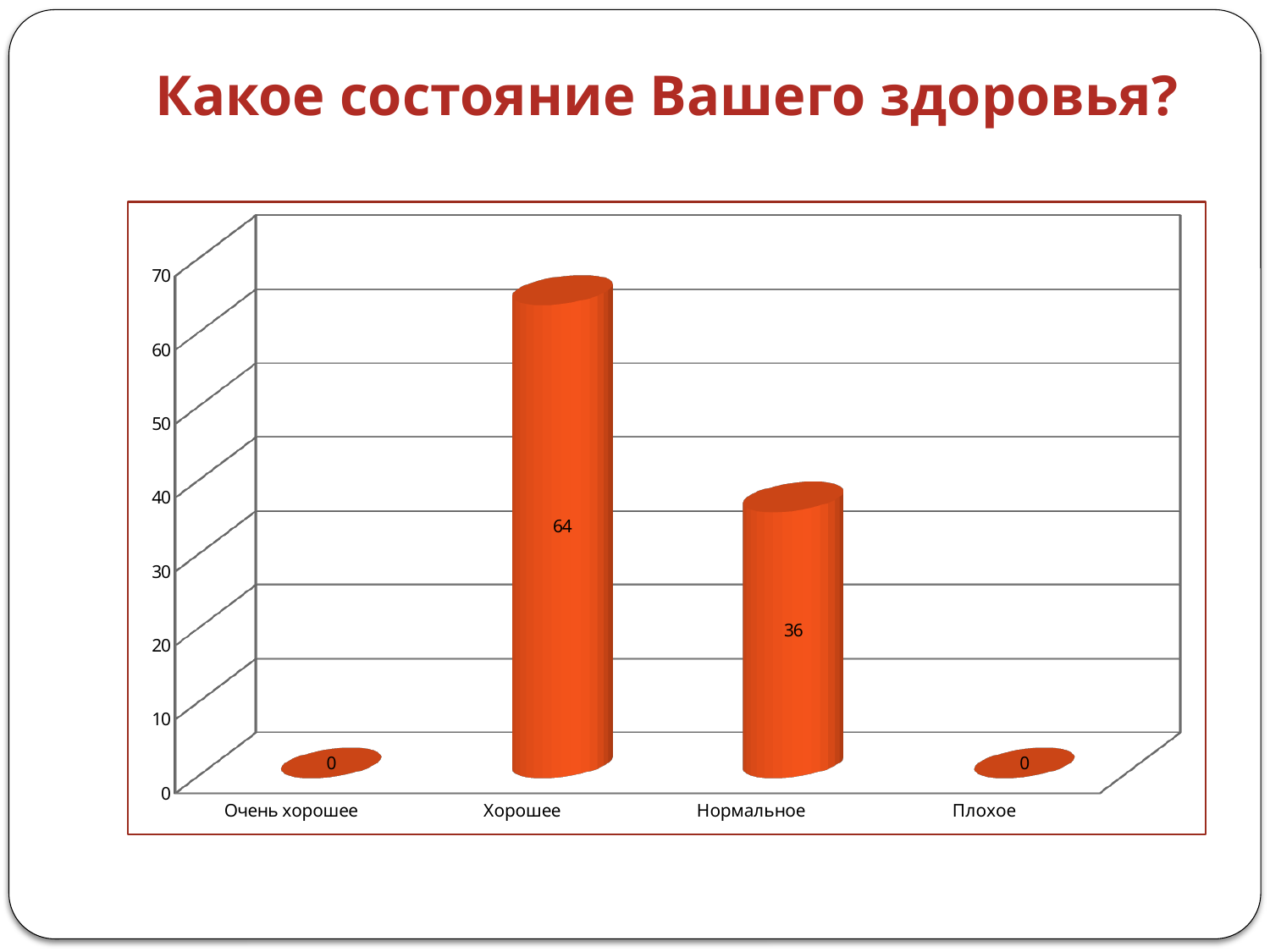
Is the value for Нормальное greater or less than 40? less What kind of chart is shown on the slide? bar chart Which is larger, the value for Хорошее or the value for Нормальное? Хорошее Which category has the highest value? Хорошее What is the value for Плохое? 0 How many categories are shown on the x axis? 4 What is the value for Очень хорошее? 0 What is the value for Хорошее? 64 What is the difference between the values for Хорошее and Нормальное? 28 What is the total of all four values shown? 100 What is the title of the slide? Какое состояние Вашего здоровья? What is the value for Нормальное? 36